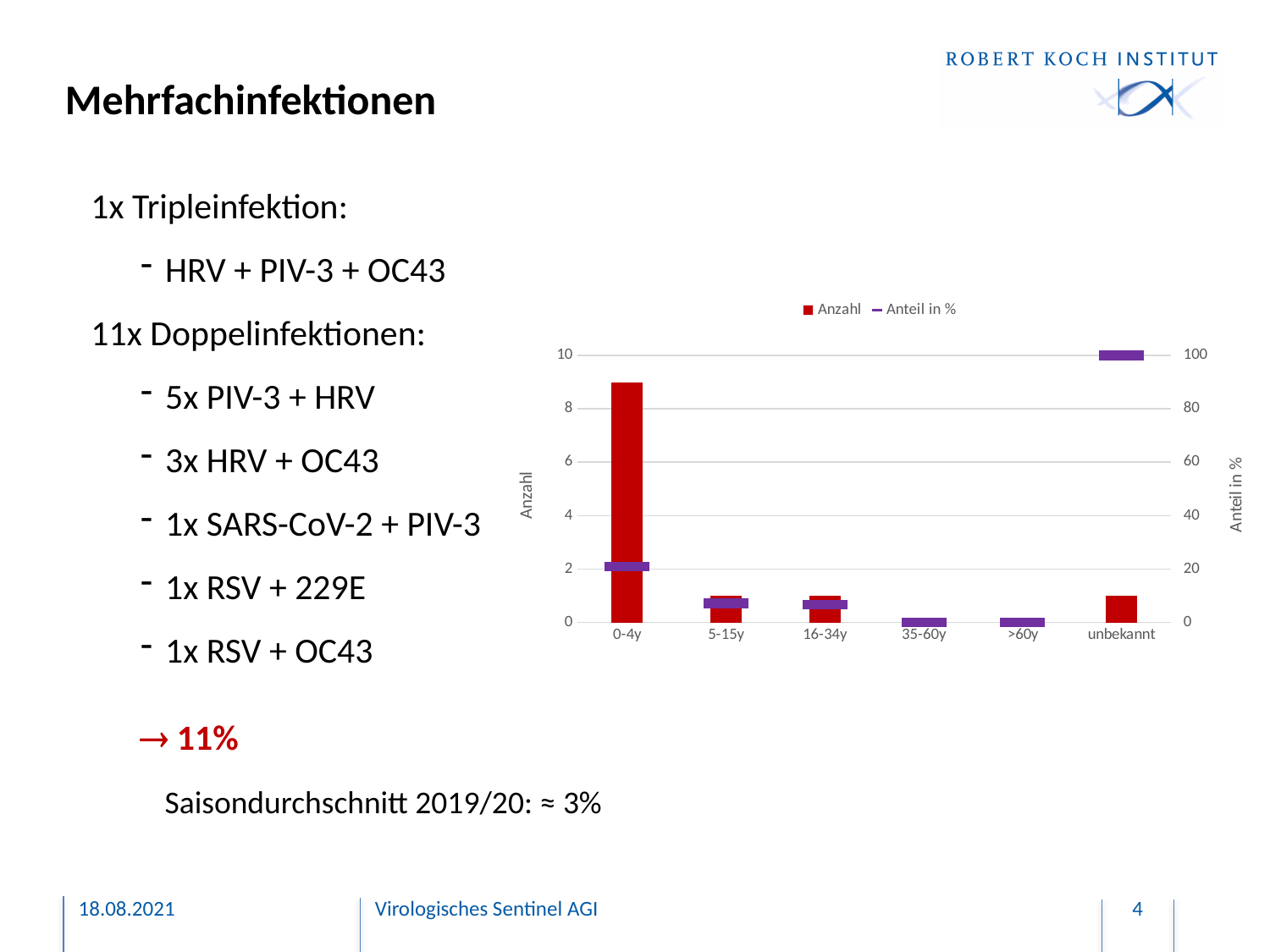
What are the two entries in the chart legend? Anzahl, Anteil in % What is the Anteil in % value for the category unbekannt? 100 What is the title of the right-hand vertical axis of the chart? Anteil in % What kind of chart is shown on the slide? bar chart Is the Anzahl value for 0-4y greater or less than 8? greater Which age group has the highest Anzahl (red bar) in the chart? 0-4y Which category has the highest Anteil in % (purple marker) in the chart? unbekannt How many age-group categories are shown on the x axis of the chart? 6 Is the Anzahl value for 5-15y greater or less than 2? less Is the Anteil in % value for 0-4y greater or less than 40? less How many series does the chart legend list? 2 Which has the larger Anzahl, 0-4y or 5-15y? 0-4y